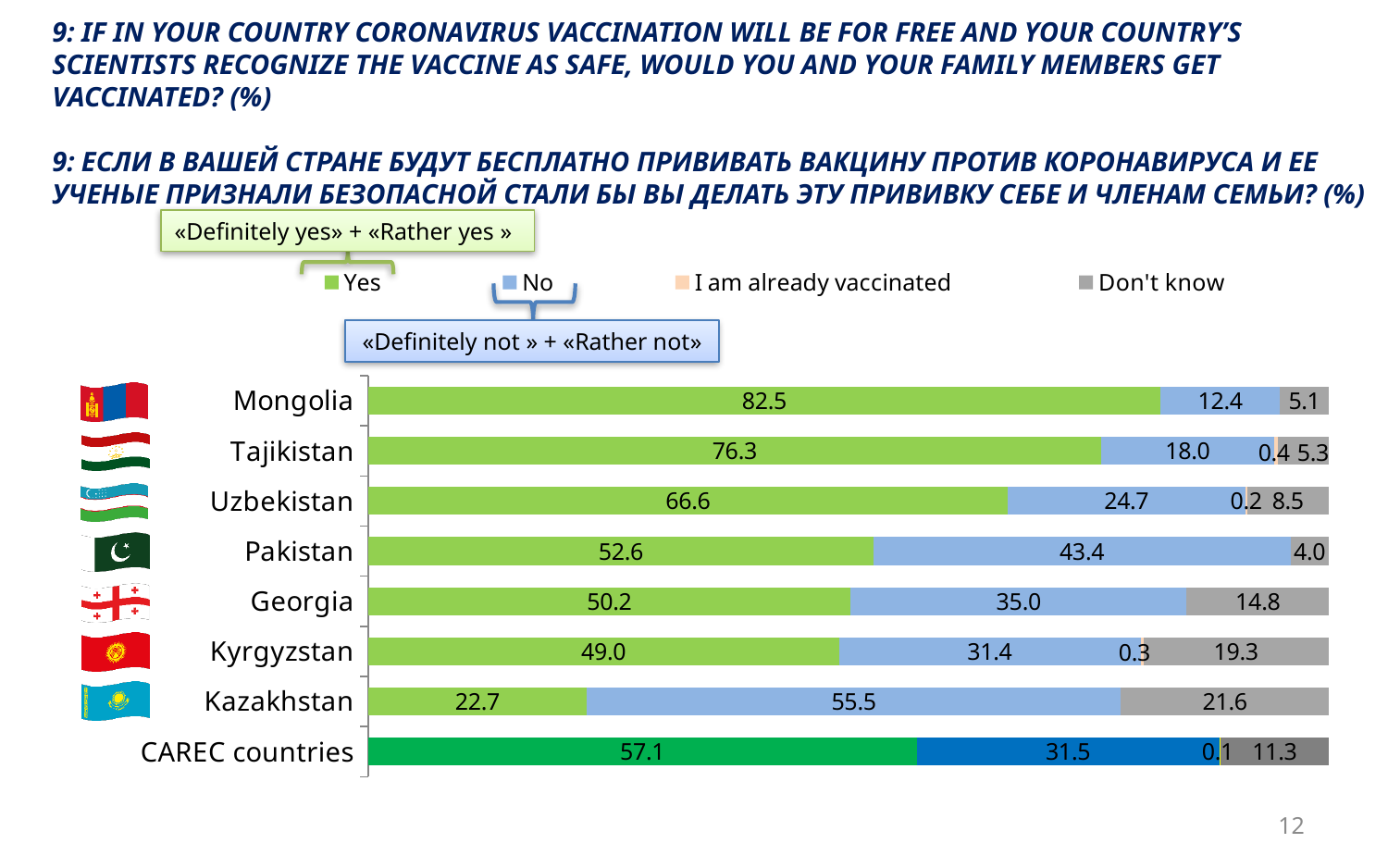
What is the "Don't know" value for Kyrgyzstan? 19.3 What is the difference between the "Yes" values for Mongolia and Kazakhstan? 59.8 Which has a larger "No" value, Pakistan or Georgia? Pakistan What is the "I am already vaccinated" value for Uzbekistan? 0.2 How many series does the legend list? 4 Which country has the lowest "Yes" value? Kazakhstan What is the "No" value for Kazakhstan? 55.5 What is the total of the stacked bar for Tajikistan? 100.0 What is the "Yes" value for Mongolia? 82.5 How many categories (rows) are shown in the chart? 8 What kind of chart is shown on the slide? Stacked bar chart Which country has the highest "Yes" value? Mongolia